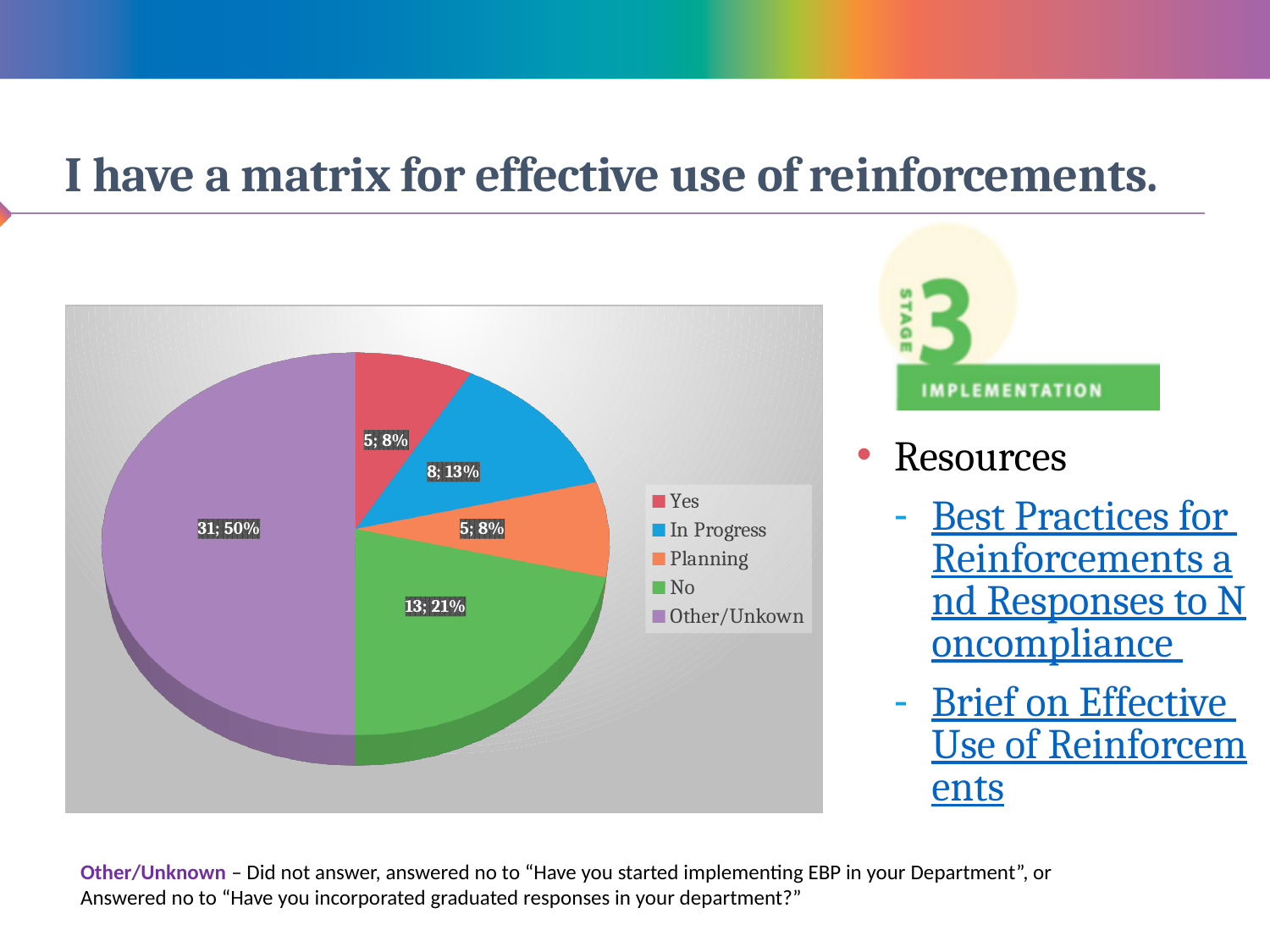
What colour is the 'No' slice in the pie chart? Green What percentage share does the 'Other/Unkown' slice have? 50% What kind of chart is shown on the slide? Pie chart What percentage share does the 'In Progress' slice have? 13% How many entries does the legend of the pie chart list? 5 How many categories does the pie chart have? 5 Which category has the largest slice in the pie chart? Other/Unkown Which is larger, the 'No' slice or the 'Planning' slice? No What is the count for the 'Yes' slice of the pie chart? 5 What percentage share does the 'Planning' slice have? 8% What is the count for the 'No' slice of the pie chart? 13 What is the difference in count between the 'No' slice and the 'In Progress' slice? 5